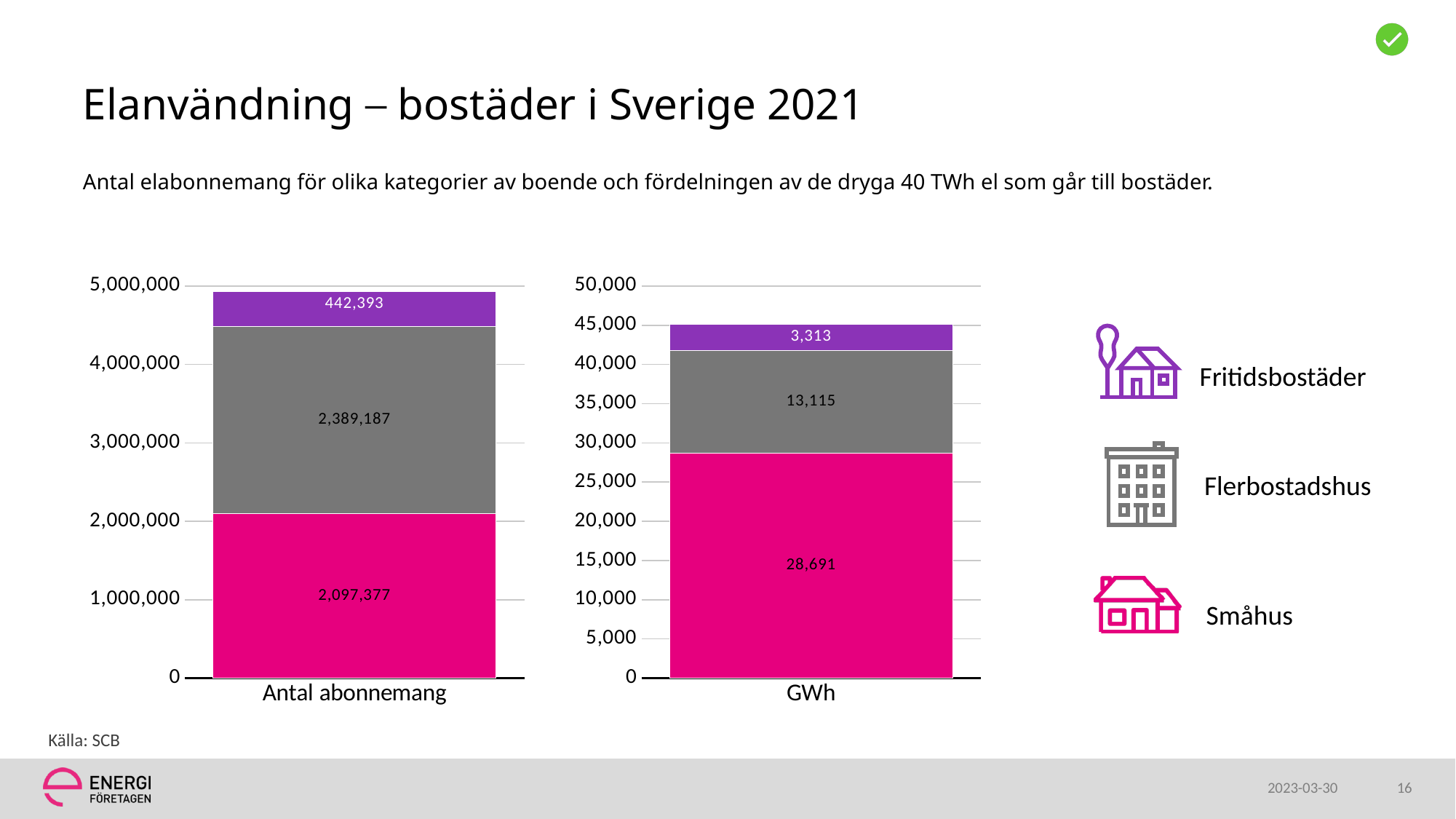
In the 'GWh' chart, what is the total of the stacked bar? 45,119 What type of chart is the 'GWh' chart? Stacked bar chart In the 'Antal abonnemang' chart, what is the value for Småhus? 2,097,377 In the 'GWh' chart, which category has the smallest value? Fritidsbostäder In the 'GWh' chart, what is the value for Flerbostadshus? 13,115 In the 'GWh' chart, what is the difference between Småhus and Flerbostadshus? 15,576 In the 'GWh' chart, what is the value for Småhus? 28,691 In the 'Antal abonnemang' chart, is Småhus or Flerbostadshus larger? Flerbostadshus In the 'GWh' chart, what is the value for Fritidsbostäder? 3,313 In the 'Antal abonnemang' chart, what is the value for Fritidsbostäder? 442,393 In the 'Antal abonnemang' chart, which category has the largest value? Flerbostadshus In the 'Antal abonnemang' chart, what is the value for Flerbostadshus? 2,389,187